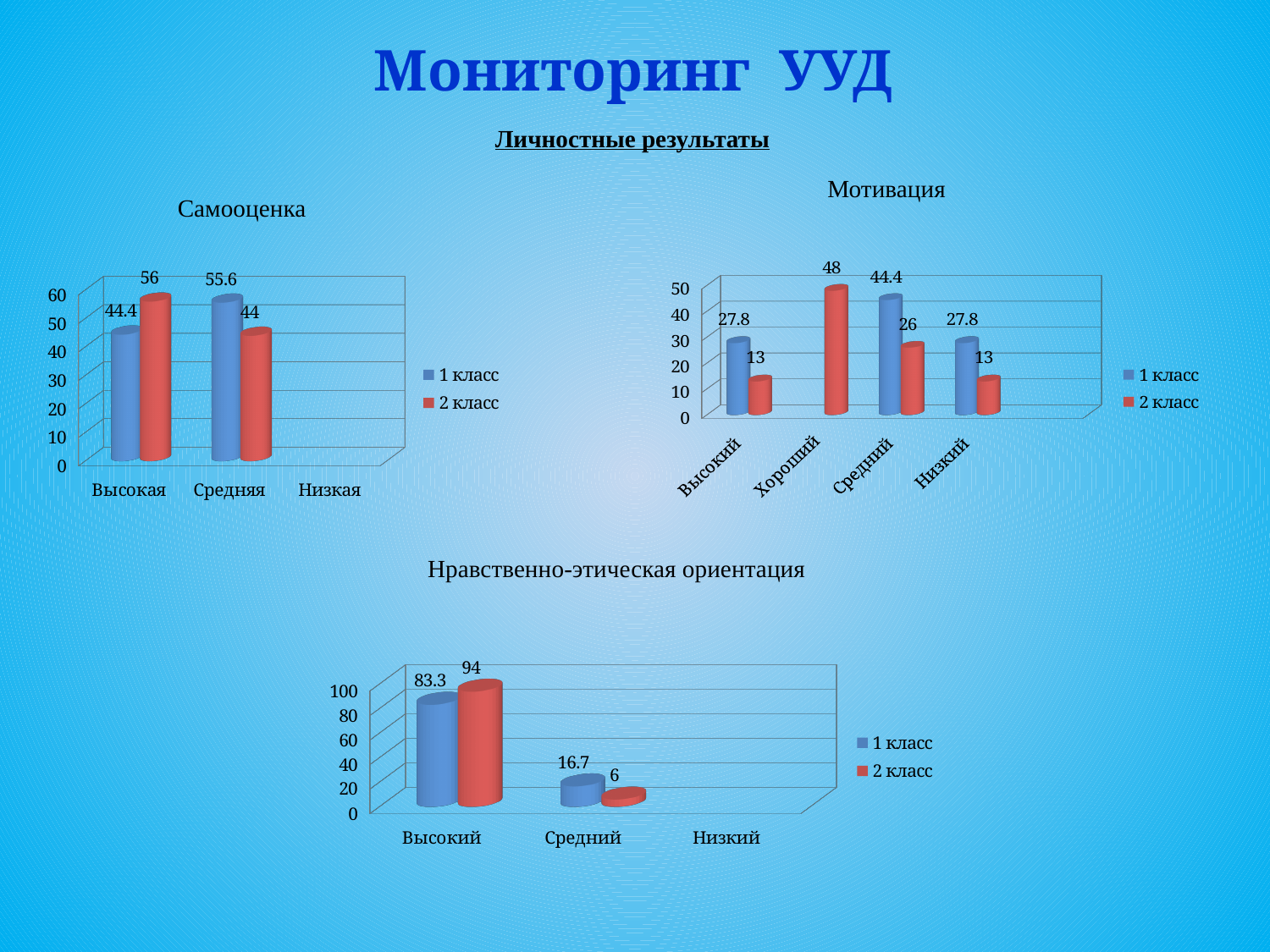
In the Нравственно-этическая ориентация chart, what is the difference between the 1 класс and 2 класс values for Средний? 10.7 In the Самооценка chart, what is the value for 2 класс in the Высокая category? 56 In the Мотивация chart, what is the value for 2 класс in the Средний category? 26 In the Нравственно-этическая ориентация chart, how many series does the legend list? 2 In the Самооценка chart, what is the value for 1 класс in the Средняя category? 55.6 In the Самооценка chart, which is larger for Средняя: 1 класс or 2 класс? 1 класс In the Мотивация chart, which category has the highest value for 1 класс? Средний In the Мотивация chart, what is the value for 2 класс in the Хороший category? 48 In the Самооценка chart, what is the difference between the 2 класс and 1 класс values for Высокая? 11.6 In the Мотивация chart, how many categories are shown on the x axis? 4 What type of chart is the Самооценка chart? Bar chart In the Нравственно-этическая ориентация chart, what is the value for 1 класс in the Высокий category? 83.3